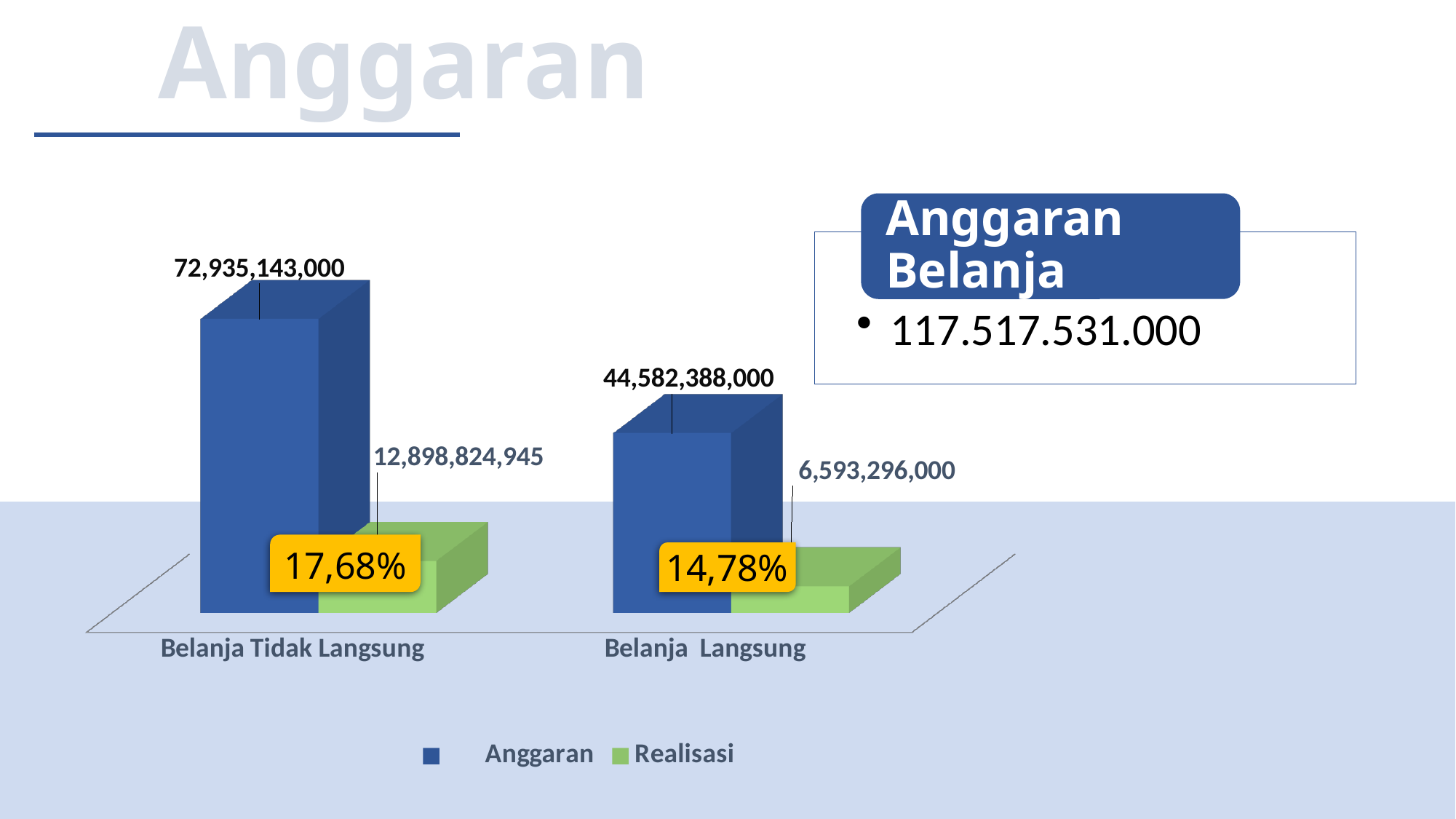
What percentage label is shown on the Belanja Langsung bars? 14,78% What is the Anggaran value for Belanja Tidak Langsung? 72,935,143,000 What is the Anggaran value for Belanja Langsung? 44,582,388,000 What is the Realisasi value for Belanja Tidak Langsung? 12,898,824,945 Which category has the lower Realisasi value? Belanja Langsung What is the difference between the Anggaran and Realisasi values for Belanja Langsung? 37,989,092,000 What kind of chart is shown on the slide? Bar chart What percentage label is shown on the Belanja Tidak Langsung bars? 17,68% What is the difference between the Anggaran values for Belanja Tidak Langsung and Belanja Langsung? 28,352,755,000 Which category has the higher Anggaran value? Belanja Tidak Langsung How many series does the legend list? 2 What is the Realisasi value for Belanja Langsung? 6,593,296,000